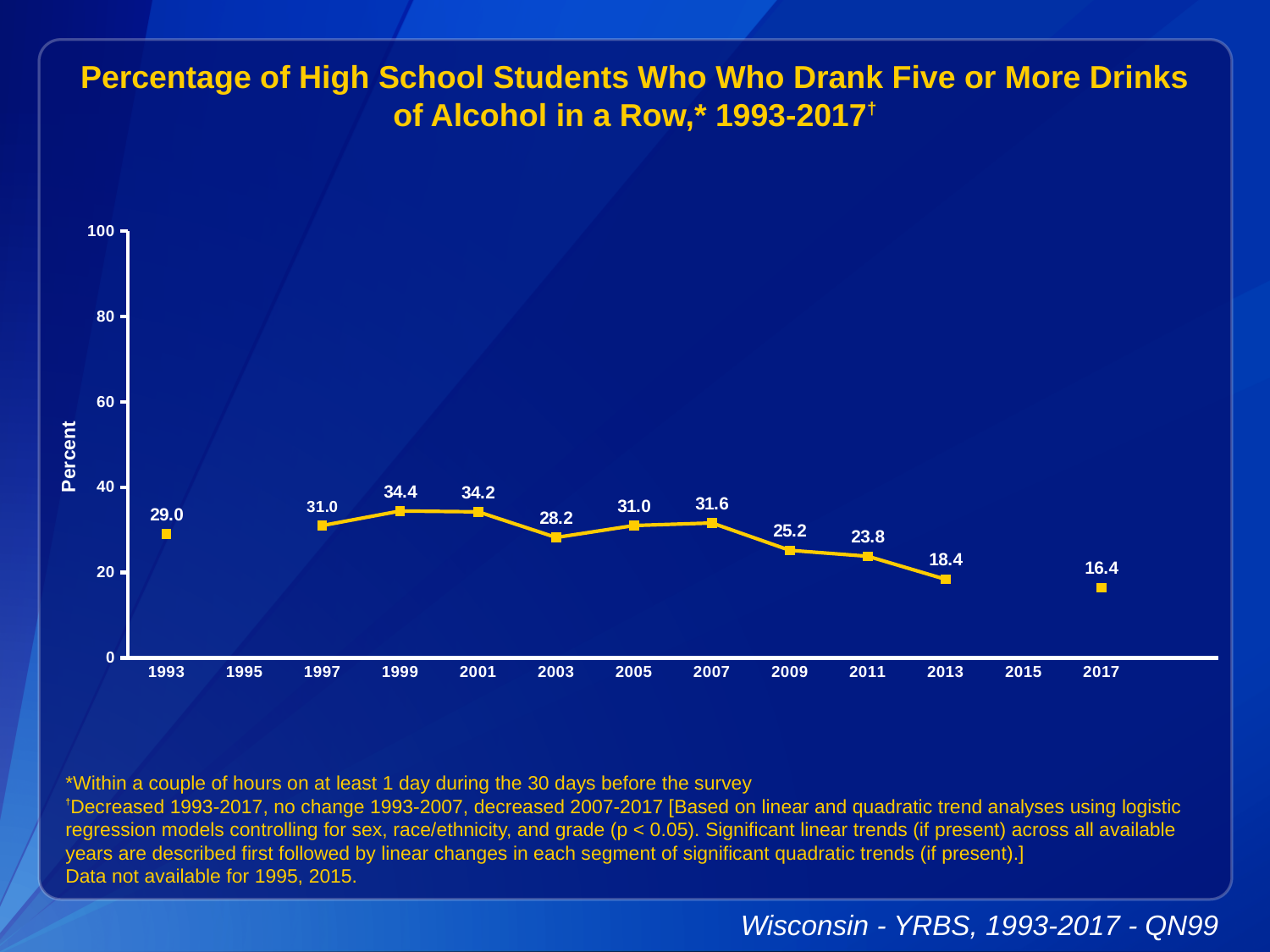
Which year has the lowest value? 2017 What is the label on the y axis? Percent Is the value for 2011 greater or less than 20? greater Which year has the highest value? 1999 What kind of chart is shown on the slide? line chart What is the value for 2017? 16.4 What is the value for 1993? 29.0 How many years have data points plotted on the chart? 11 What is the difference between the values for 2007 and 2013? 13.2 Do the values rise or fall from 2007 to 2017? fall What is the value for 1999? 34.4 Which is larger, the value for 2003 or the value for 2005? 2005